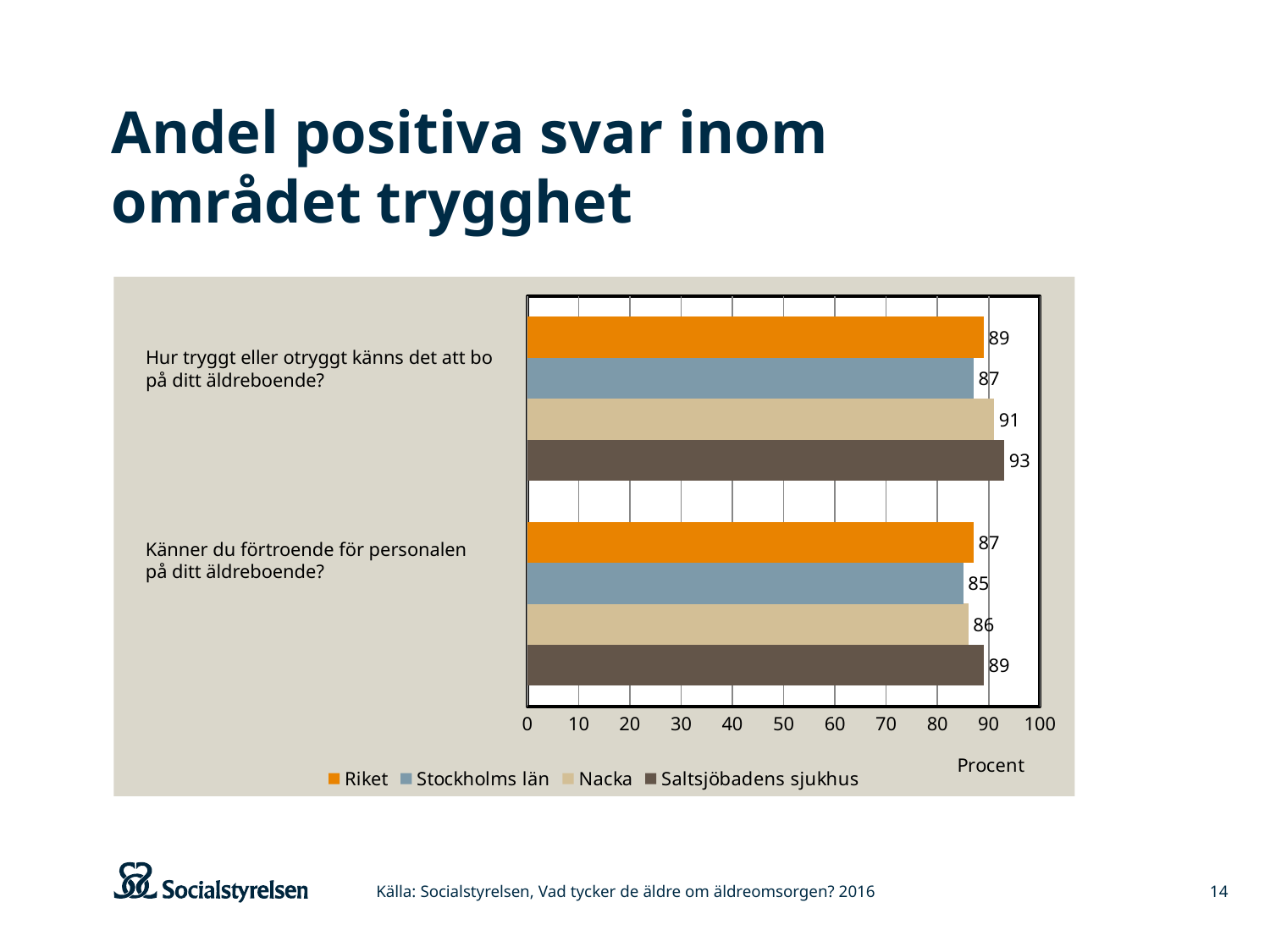
Is the value for Riket for the question "Känner du förtroende för personalen på ditt äldreboende?" greater or less than 80? greater How many series does the legend list? 4 Which series has the lowest value for the question "Känner du förtroende för personalen på ditt äldreboende?"? Stockholms län What is the value for Nacka for the question "Känner du förtroende för personalen på ditt äldreboende?"? 86 Which is larger for Nacka: the value for "Hur tryggt eller otryggt känns det att bo på ditt äldreboende?" or for "Känner du förtroende för personalen på ditt äldreboende?"? Hur tryggt eller otryggt känns det att bo på ditt äldreboende? What unit is shown on the x axis of the chart? Procent What is the difference between the Saltsjöbadens sjukhus and Stockholms län values for the question "Hur tryggt eller otryggt känns det att bo på ditt äldreboende?"? 6 What is the value for Riket for the question "Hur tryggt eller otryggt känns det att bo på ditt äldreboende?"? 89 Which series has the highest value for the question "Hur tryggt eller otryggt känns det att bo på ditt äldreboende?"? Saltsjöbadens sjukhus What is the value for Stockholms län for the question "Känner du förtroende för personalen på ditt äldreboende?"? 85 What kind of chart is shown on the slide? Bar chart What is the value for Saltsjöbadens sjukhus for the question "Hur tryggt eller otryggt känns det att bo på ditt äldreboende?"? 93